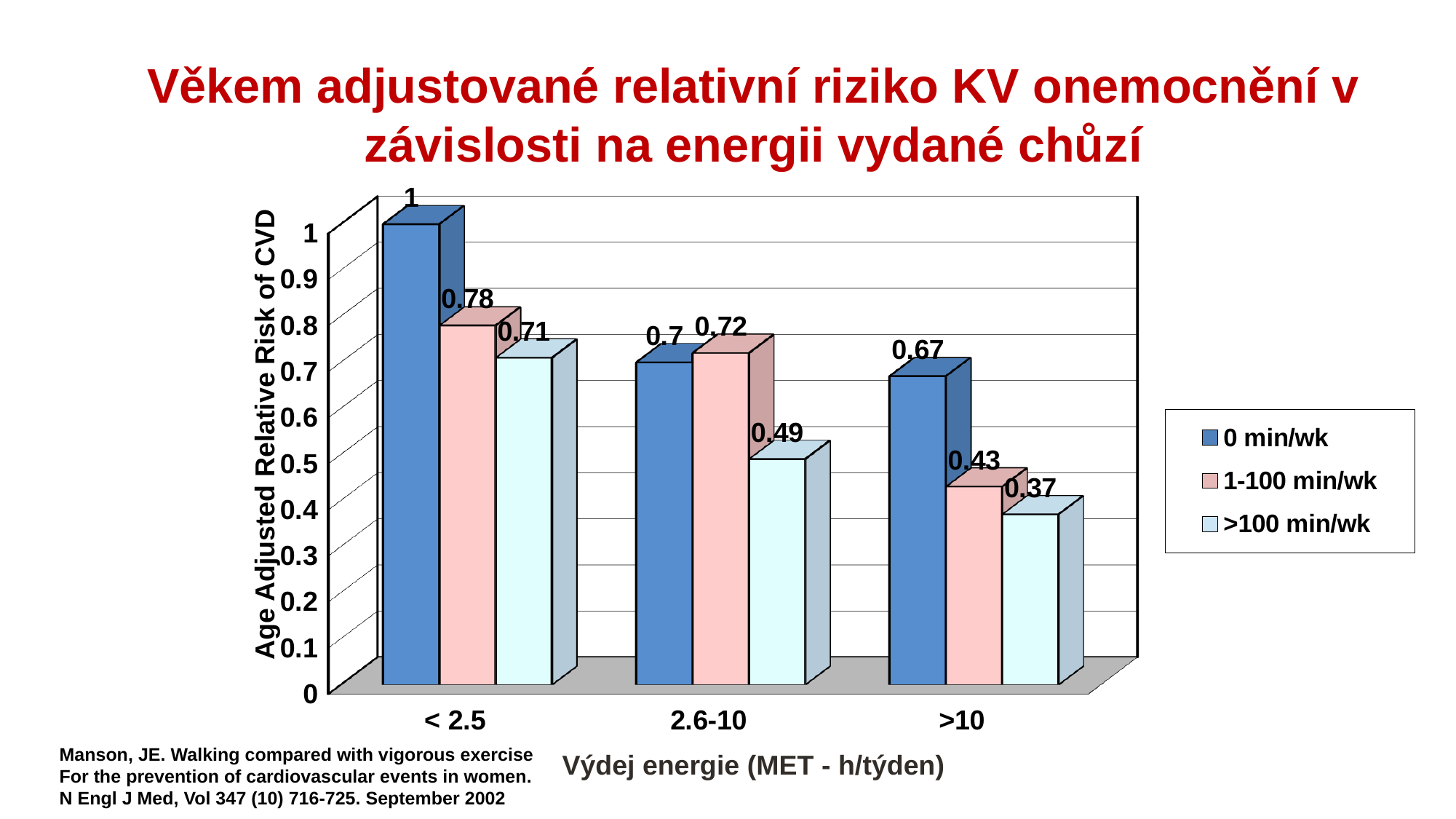
Which category has the lowest value for >100 min/wk? >10 How many categories are shown on the x axis? 3 What is the value for 1-100 min/wk in the < 2.5 category? 0.78 Which series has the highest value in the >10 category? 0 min/wk What is the difference between the 0 min/wk value and the >100 min/wk value in the >10 category? 0.3 What is the value for >100 min/wk in the 2.6-10 category? 0.49 Do the values for >100 min/wk rise or fall across the categories from < 2.5 to >10? Fall How many series does the legend list? 3 What kind of chart is shown on the slide? Bar chart What is the value for 1-100 min/wk in the >10 category? 0.43 What is the value for 0 min/wk in the < 2.5 category? 1 Which is larger in the 2.6-10 category: the 0 min/wk value or the >100 min/wk value? 0 min/wk